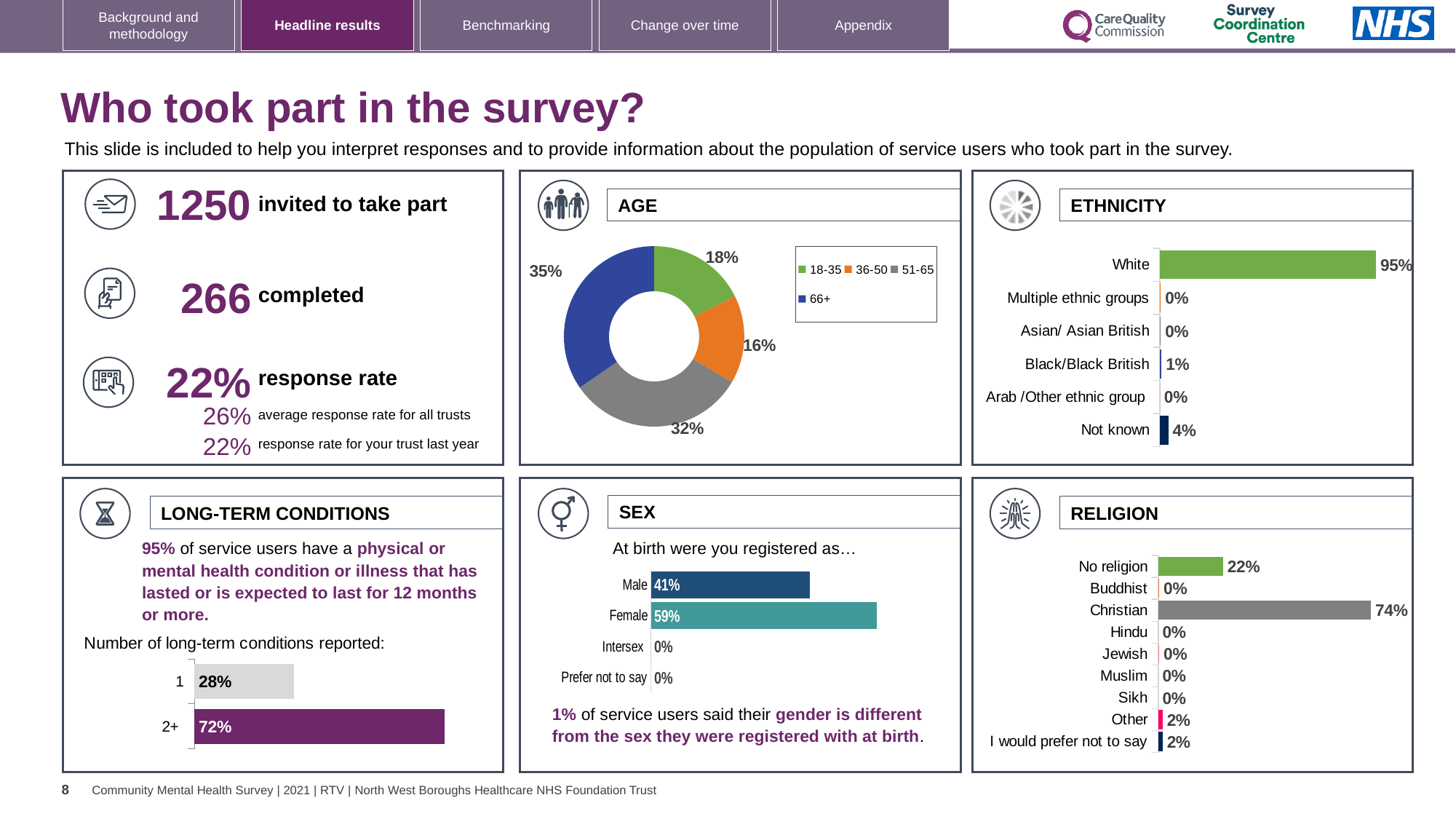
In the SEX chart, what percentage were registered as Male at birth? 41% How many categories are shown in the RELIGION chart? 9 In the ETHNICITY chart, what is the value for Not known? 4% How many categories are shown in the ETHNICITY chart? 6 How many age groups does the legend of the AGE chart list? 4 In the SEX chart, which is larger, Male or Female? Female In the AGE chart, what percentage of respondents are aged 66+? 35% In the AGE chart, which age group has the smallest share? 36-50 What kind of chart is the AGE chart? Donut chart In the LONG-TERM CONDITIONS chart, what is the difference between the value for 2+ and the value for 1? 44% In the RELIGION chart, what is the value for Christian? 74% In the ETHNICITY chart, which category has the highest value? White